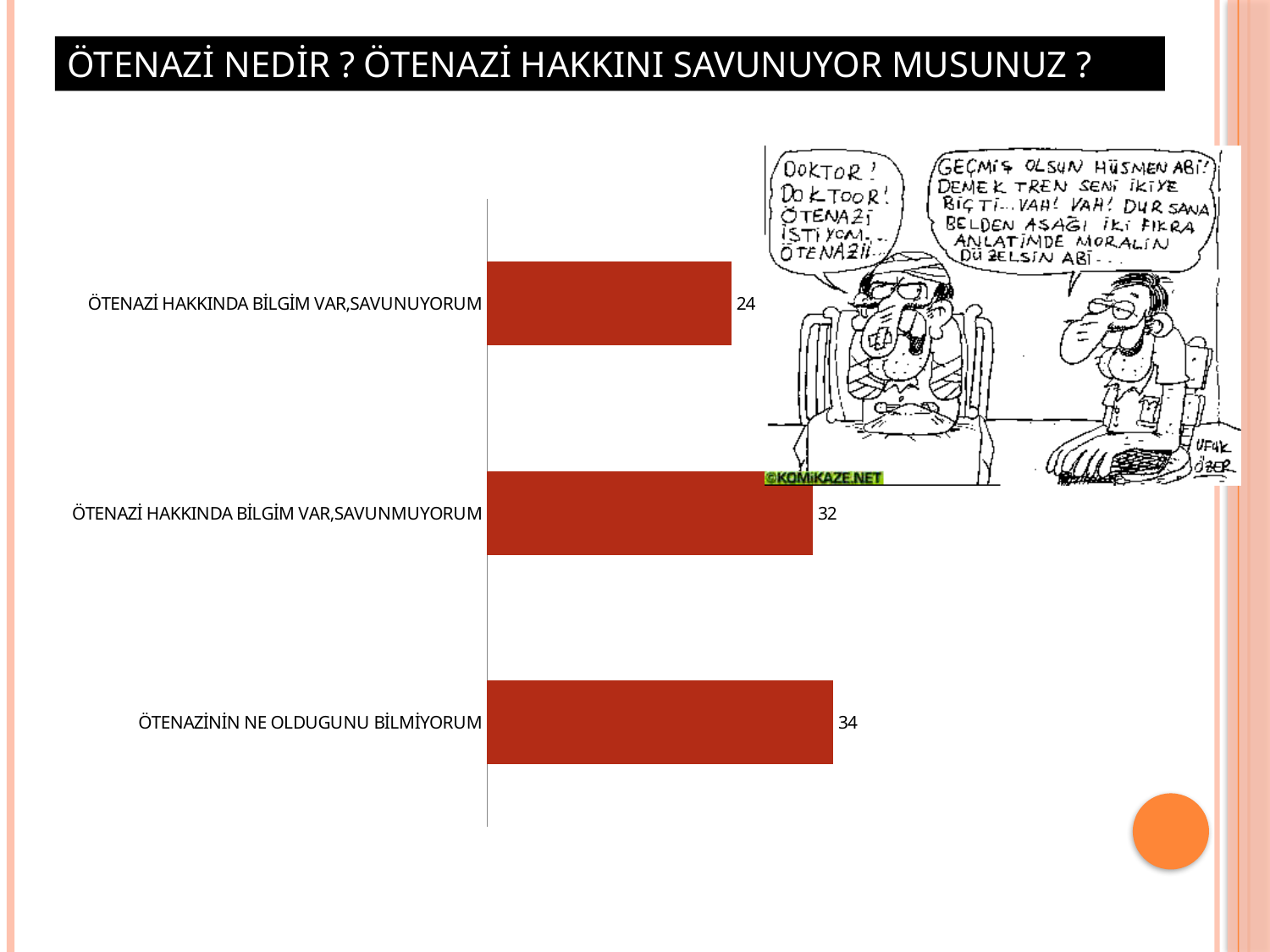
Which category has the highest value? ÖTENAZİNİN NE OLDUGUNU BİLMİYORUM What is the total of the three values shown in the chart? 90 What is the difference between the values for ÖTENAZİNİN NE OLDUGUNU BİLMİYORUM and ÖTENAZİ HAKKINDA BİLGİM VAR,SAVUNUYORUM? 10 What is the value for ÖTENAZİNİN NE OLDUGUNU BİLMİYORUM? 34 Which category has the lowest value? ÖTENAZİ HAKKINDA BİLGİM VAR,SAVUNUYORUM What is the value for ÖTENAZİ HAKKINDA BİLGİM VAR,SAVUNUYORUM? 24 How many categories does the chart show? 3 What is the value for ÖTENAZİ HAKKINDA BİLGİM VAR,SAVUNMUYORUM? 32 What kind of chart is shown on the slide? bar chart What colour are the bars in the chart? red What is the difference between the values for ÖTENAZİ HAKKINDA BİLGİM VAR,SAVUNMUYORUM and ÖTENAZİ HAKKINDA BİLGİM VAR,SAVUNUYORUM? 8 Which is larger: the value for ÖTENAZİ HAKKINDA BİLGİM VAR,SAVUNMUYORUM or for ÖTENAZİ HAKKINDA BİLGİM VAR,SAVUNUYORUM? ÖTENAZİ HAKKINDA BİLGİM VAR,SAVUNMUYORUM